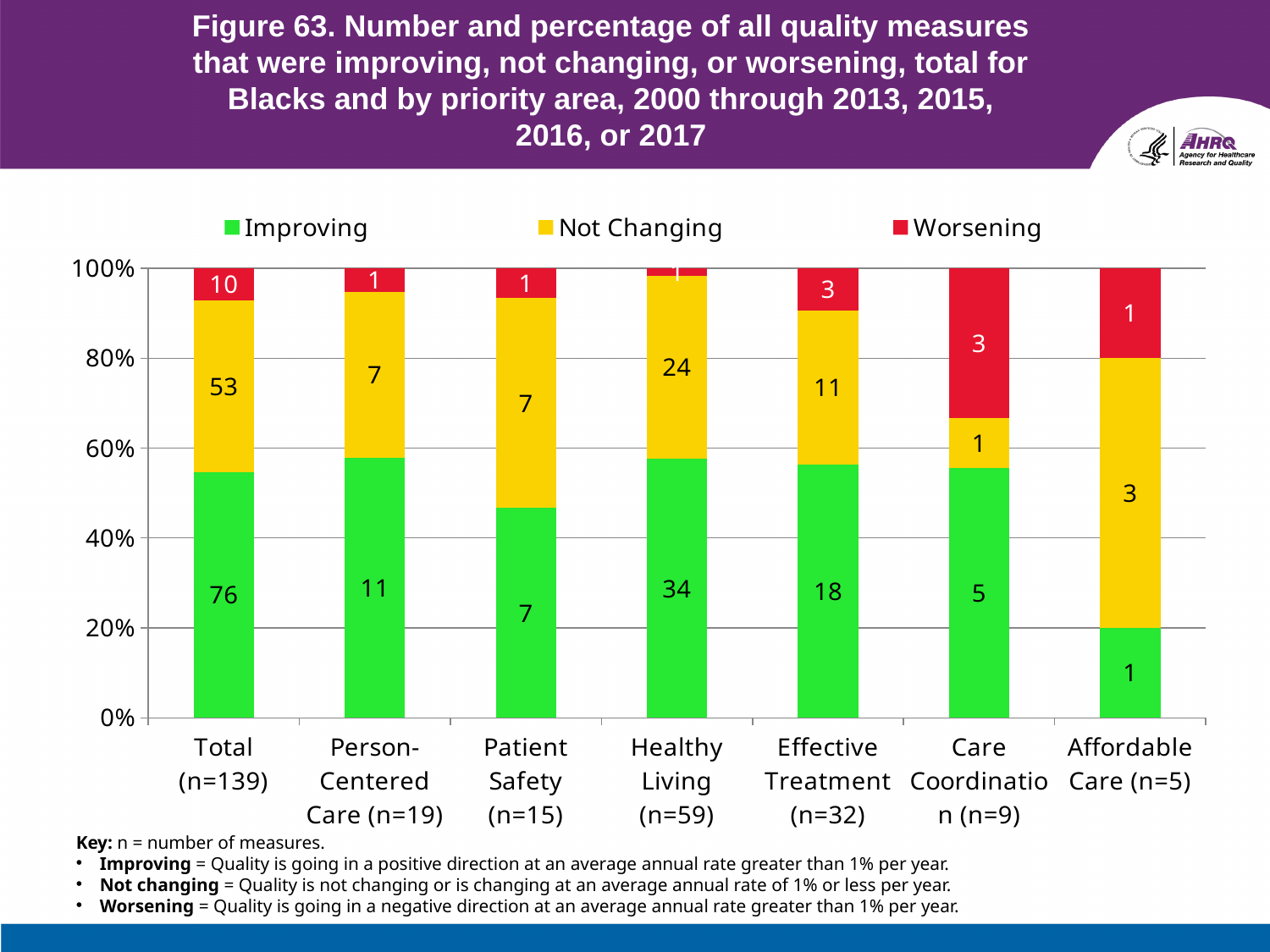
How many categories are shown on the x axis? 7 What is the Improving value for Affordable Care (n=5)? 1 What is the number of Not Changing measures for Healthy Living (n=59)? 24 Is the Improving share of the Affordable Care (n=5) bar greater or less than 40%? less Which is larger for Effective Treatment (n=32): the Improving count or the Not Changing count? Improving What is the difference between the Improving and Not Changing counts for Total (n=139)? 23 How many Improving measures are shown for Total (n=139)? 76 What type of chart is shown on the slide? Stacked bar chart How many series does the legend list? 3 Which category has the lowest number of Not Changing measures? Care Coordination (n=9) How many Worsening measures are shown for Care Coordination (n=9)? 3 Which priority area (excluding Total) has the highest number of Improving measures? Healthy Living (n=59)